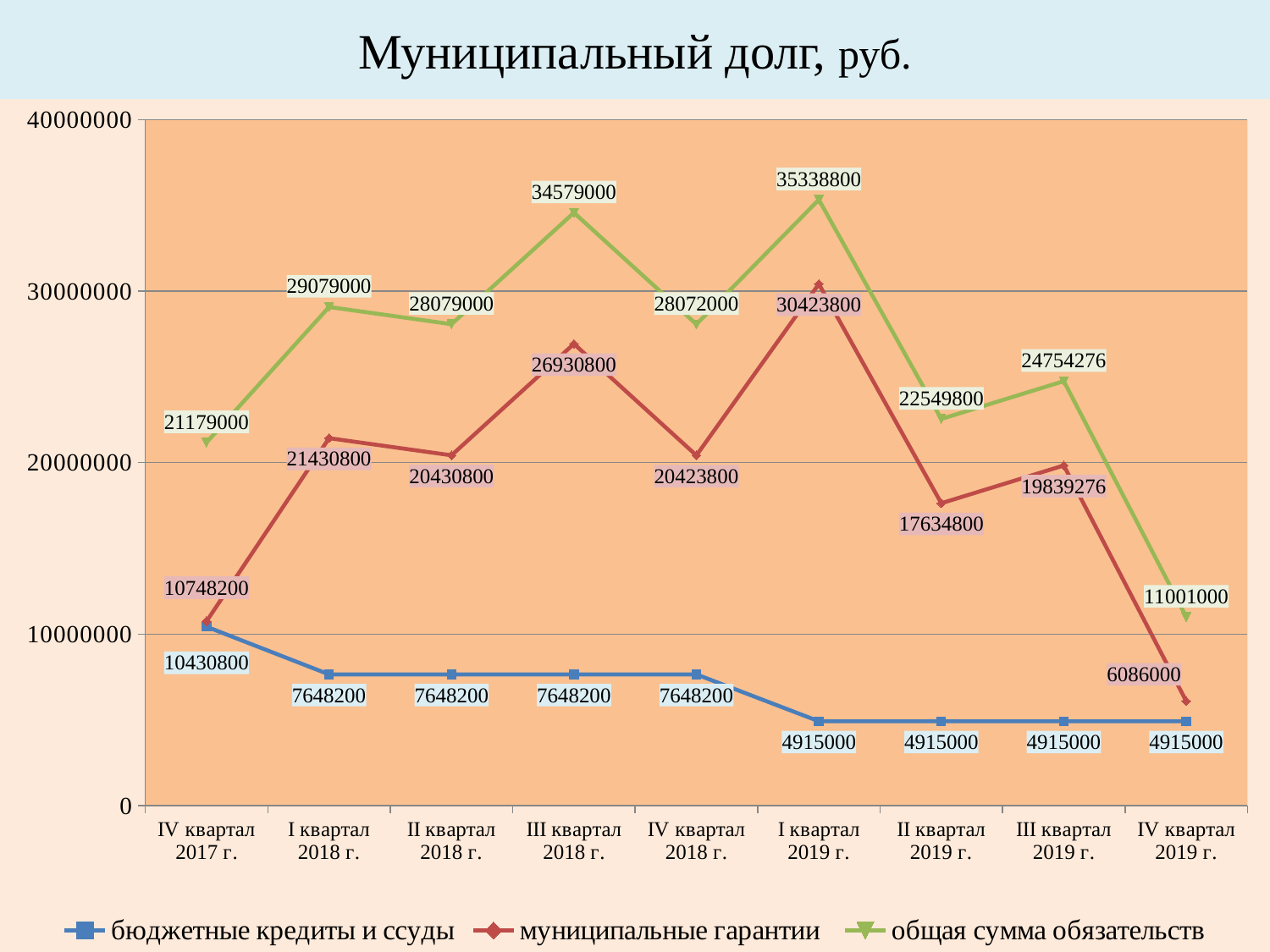
In which quarter is общая сумма обязательств the highest? I квартал 2019 г. How many series does the legend list? 3 What is the value of бюджетные кредиты и ссуды for IV квартал 2017 г.? 10430800 What is the title of the chart? Муниципальный долг, руб. How many quarters are plotted along the x axis? 9 In which quarter is муниципальные гарантии the lowest? IV квартал 2019 г. What is the value of муниципальные гарантии for III квартал 2018 г.? 26930800 What type of chart is shown on the slide? line chart Which is larger in II квартал 2019 г.: муниципальные гарантии or бюджетные кредиты и ссуды? муниципальные гарантии What is the value of общая сумма обязательств for I квартал 2019 г.? 35338800 Is the value of общая сумма обязательств for III квартал 2018 г. greater or less than 30000000? greater What is the difference between общая сумма обязательств and муниципальные гарантии in IV квартал 2019 г.? 4915000